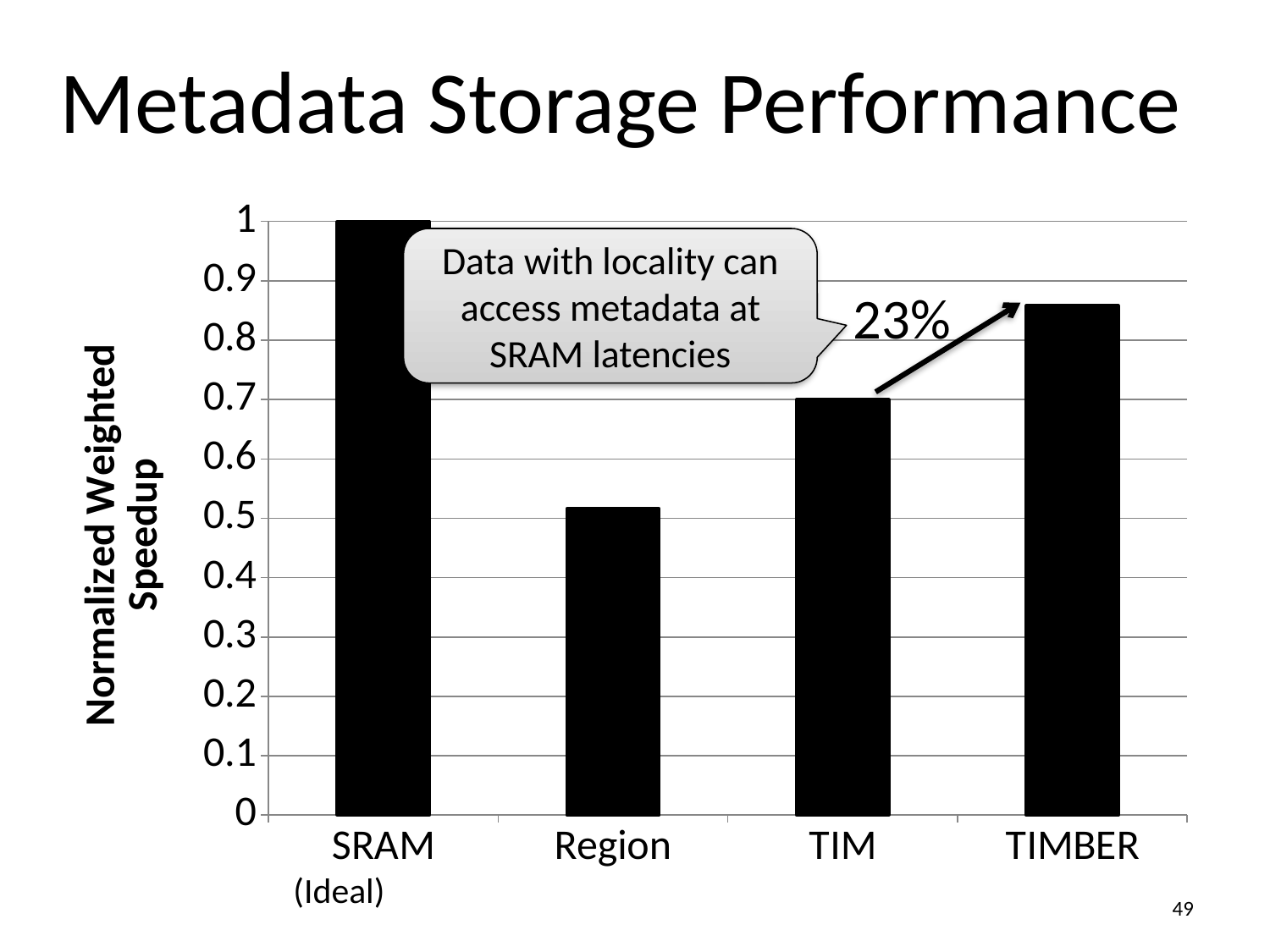
Is the value for Region greater or less than 0.6? less Is the value for TIMBER greater or less than 0.8? greater Is the value for TIM greater or less than 0.8? less How many categories are plotted on the x axis? 4 What is the label of the y axis? Normalized Weighted Speedup Which category has the highest normalized weighted speedup? SRAM (Ideal) What percentage improvement is annotated between TIM and TIMBER? 23% What is the normalized weighted speedup for SRAM (Ideal)? 1 What kind of chart is shown on the slide? bar chart Which has a higher normalized weighted speedup, TIMBER or TIM? TIMBER Which has a higher normalized weighted speedup, TIM or Region? TIM Which category has the lowest normalized weighted speedup? Region